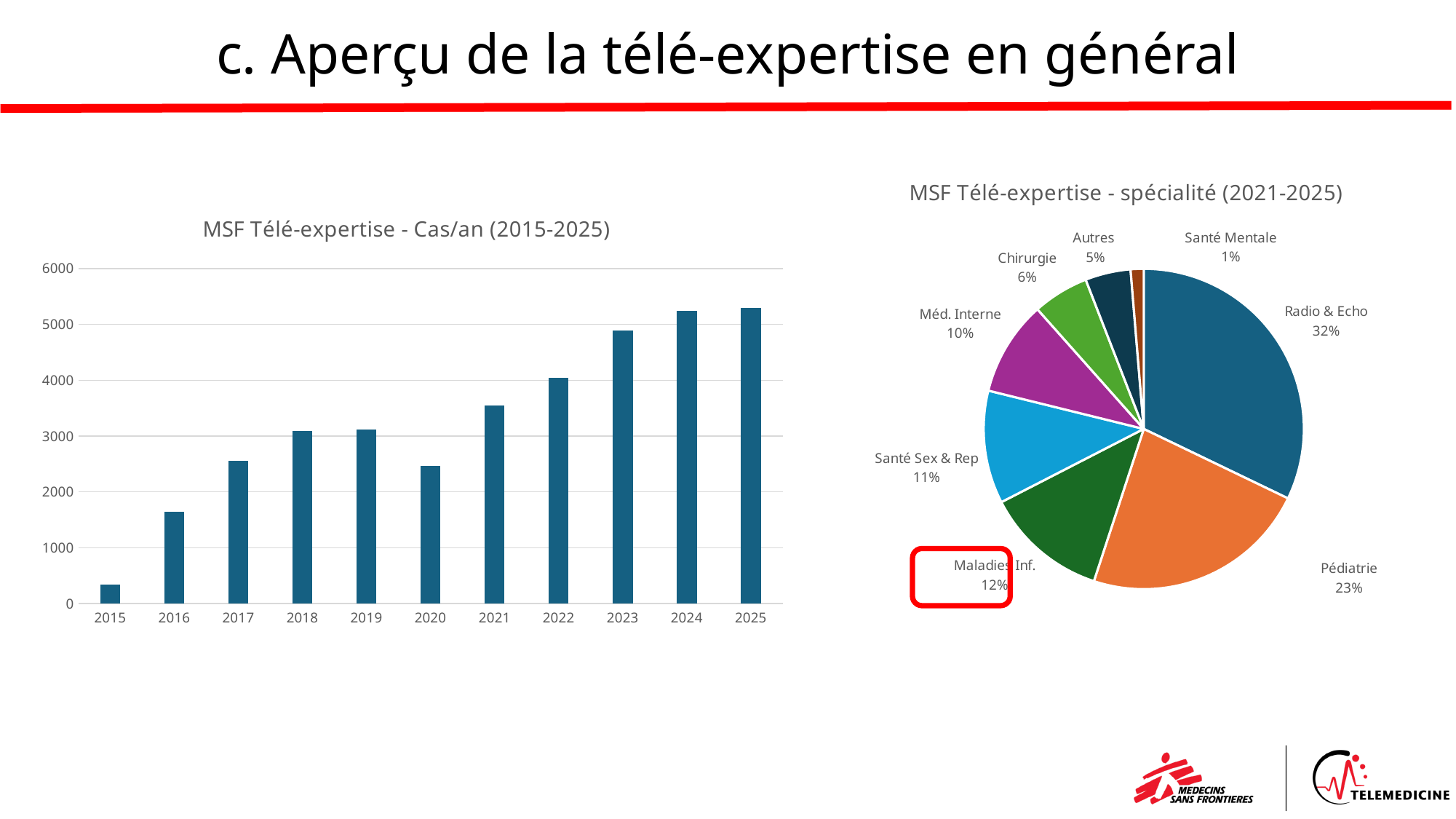
What kind of chart is 'MSF Télé-expertise - spécialité (2021-2025)'? Pie chart In the chart 'MSF Télé-expertise - spécialité (2021-2025)', what share does Radio & Echo have? 32% In the chart 'MSF Télé-expertise - spécialité (2021-2025)', what percentage is shown for Maladies Inf.? 12% In the chart 'MSF Télé-expertise - spécialité (2021-2025)', which specialty has the smallest share? Santé Mentale In the chart 'MSF Télé-expertise - Cas/an (2015-2025)', which year has the larger value, 2019 or 2020? 2019 In the chart 'MSF Télé-expertise - spécialité (2021-2025)', how many slices does the pie have? 8 In the chart 'MSF Télé-expertise - Cas/an (2015-2025)', which year has the lowest value? 2015 In the chart 'MSF Télé-expertise - Cas/an (2015-2025)', how many years are shown on the x axis? 11 In the chart 'MSF Télé-expertise - spécialité (2021-2025)', how many percentage points larger is Radio & Echo than Pédiatrie? 9 In the chart 'MSF Télé-expertise - Cas/an (2015-2025)', is the value for 2020 greater or less than 3000? less In the chart 'MSF Télé-expertise - spécialité (2021-2025)', which specialty has the largest share? Radio & Echo In the chart 'MSF Télé-expertise - Cas/an (2015-2025)', is the value for 2024 greater or less than 5000? greater